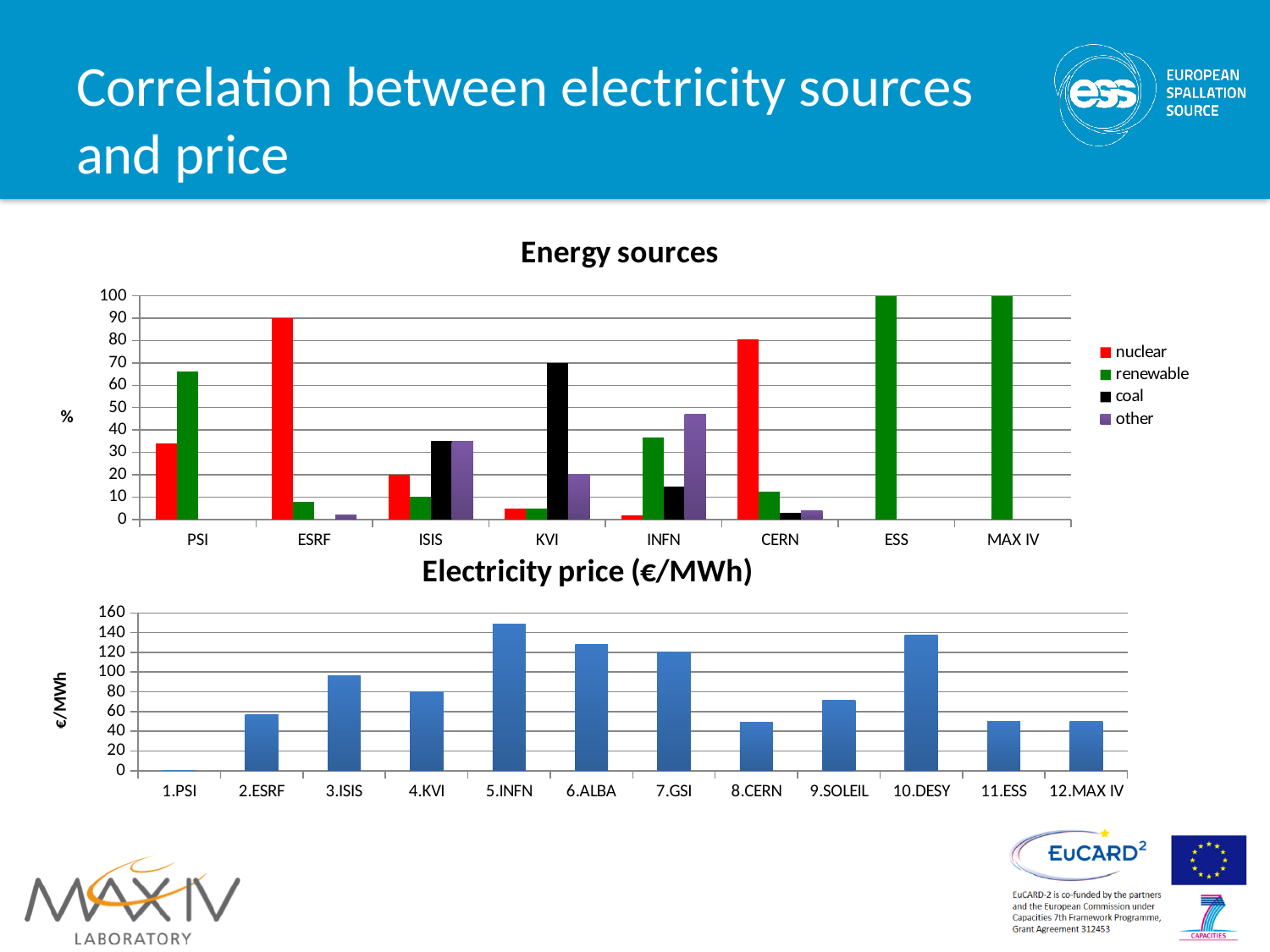
In the Energy sources chart, how many series does the legend list? 4 In the Energy sources chart, is the renewable value for PSI greater or less than 60? greater In the Energy sources chart, which facility has the highest nuclear share? ESRF In the Energy sources chart, which is larger for INFN, the coal value or the other value? other In the Energy sources chart, what is the coal value for KVI? 70 In the Electricity price (€/MWh) chart, which is larger, the value for 3.ISIS or the value for 9.SOLEIL? 3.ISIS In the Electricity price (€/MWh) chart, how many facilities are shown on the x axis? 12 What type of chart is the Electricity price (€/MWh) chart? bar chart In the Energy sources chart, what is the nuclear value for ESRF? 90 In the Electricity price (€/MWh) chart, is the value for 10.DESY greater or less than 120? greater In the Electricity price (€/MWh) chart, which facility has the highest electricity price? 5.INFN In the Energy sources chart, what is the renewable value for ESS? 100